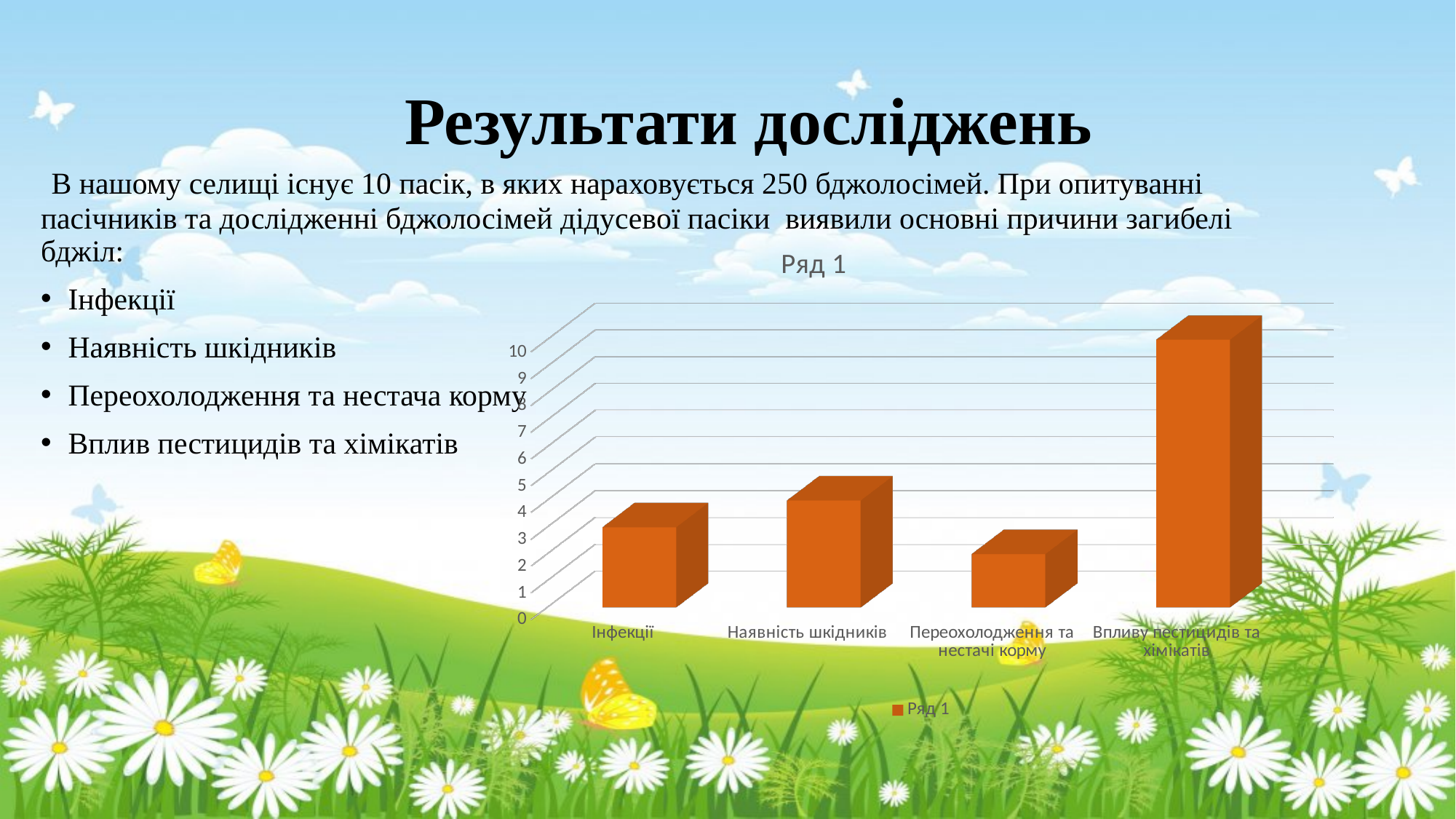
What is the title of the chart? Ряд 1 Which category has the highest bar in the chart? Впливу пестицидів та хімікатів What is the name of the series shown in the chart legend? Ряд 1 How many categories are plotted in the chart? 4 Is the value for Переохолодження та нестачі корму greater or less than 4? less Is the value for Впливу пестицидів та хімікатів greater or less than 8? greater Which is larger in the chart: the value for Інфекції or the value for Переохолодження та нестачі корму? Інфекції How many series does the chart legend list? 1 Is the value for Інфекції greater or less than 5? less Which is larger in the chart: the value for Інфекції or the value for Наявність шкідників? Наявність шкідників What kind of chart is shown on the slide? bar chart Which category has the lowest bar in the chart? Переохолодження та нестачі корму